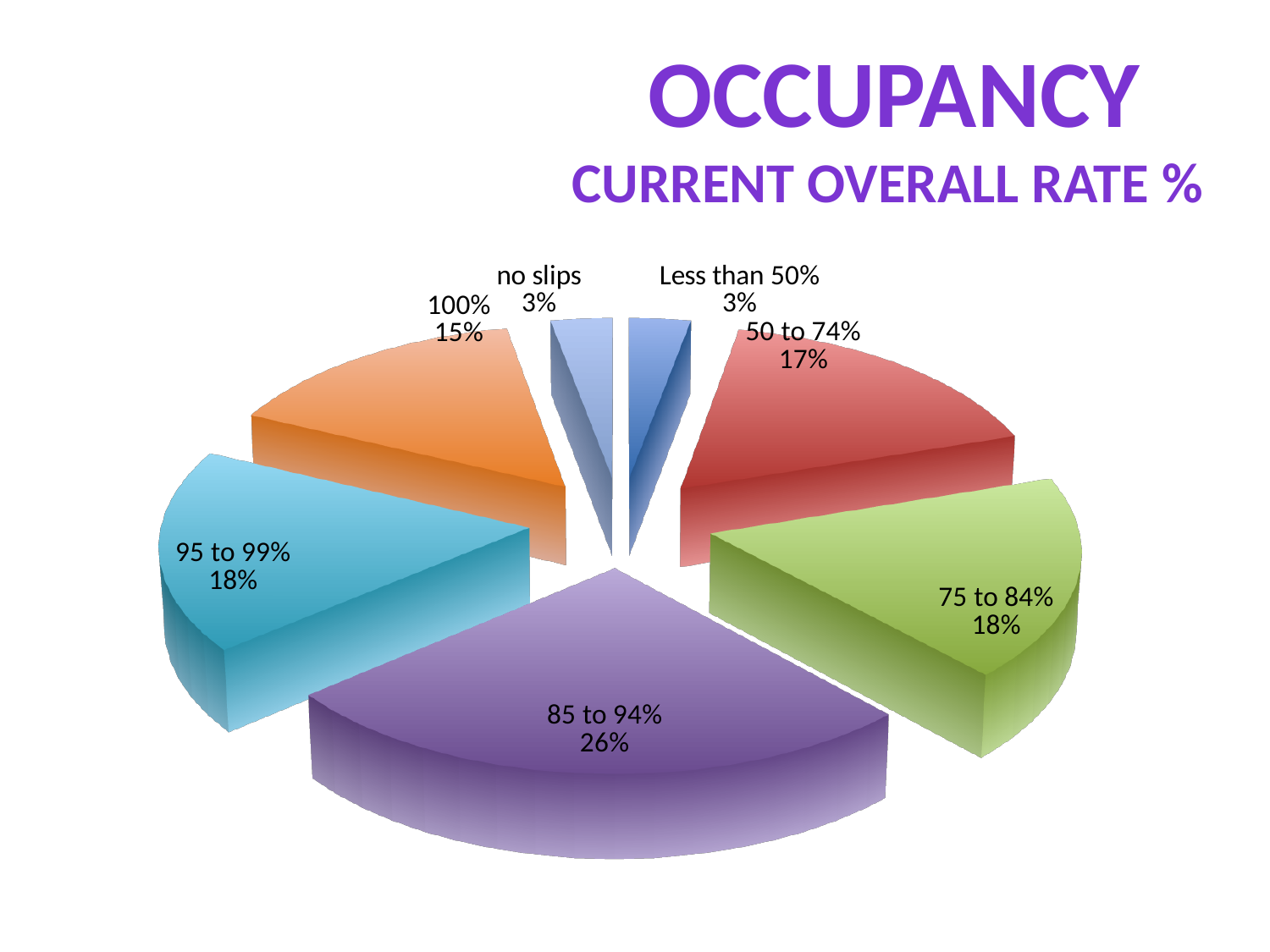
What is the title of the chart on the slide? OCCUPANCY CURRENT OVERALL RATE % What share of the pie does the "85 to 94%" slice represent? 26% What is the value shown for the "no slips" category? 3% How many slices does the pie chart have? 7 Which is larger, the "50 to 74%" slice or the "100%" slice? 50 to 74% What is the value shown for the "95 to 99%" category? 18% What is the difference in percentage points between the "85 to 94%" slice and the "50 to 74%" slice? 9 What kind of chart is shown on the slide? pie chart What is the value shown for the "50 to 74%" category? 17% What is the value shown for the "100%" category? 15% Which is larger, the "85 to 94%" slice or the "75 to 84%" slice? 85 to 94% Which category has the largest slice of the pie? 85 to 94%